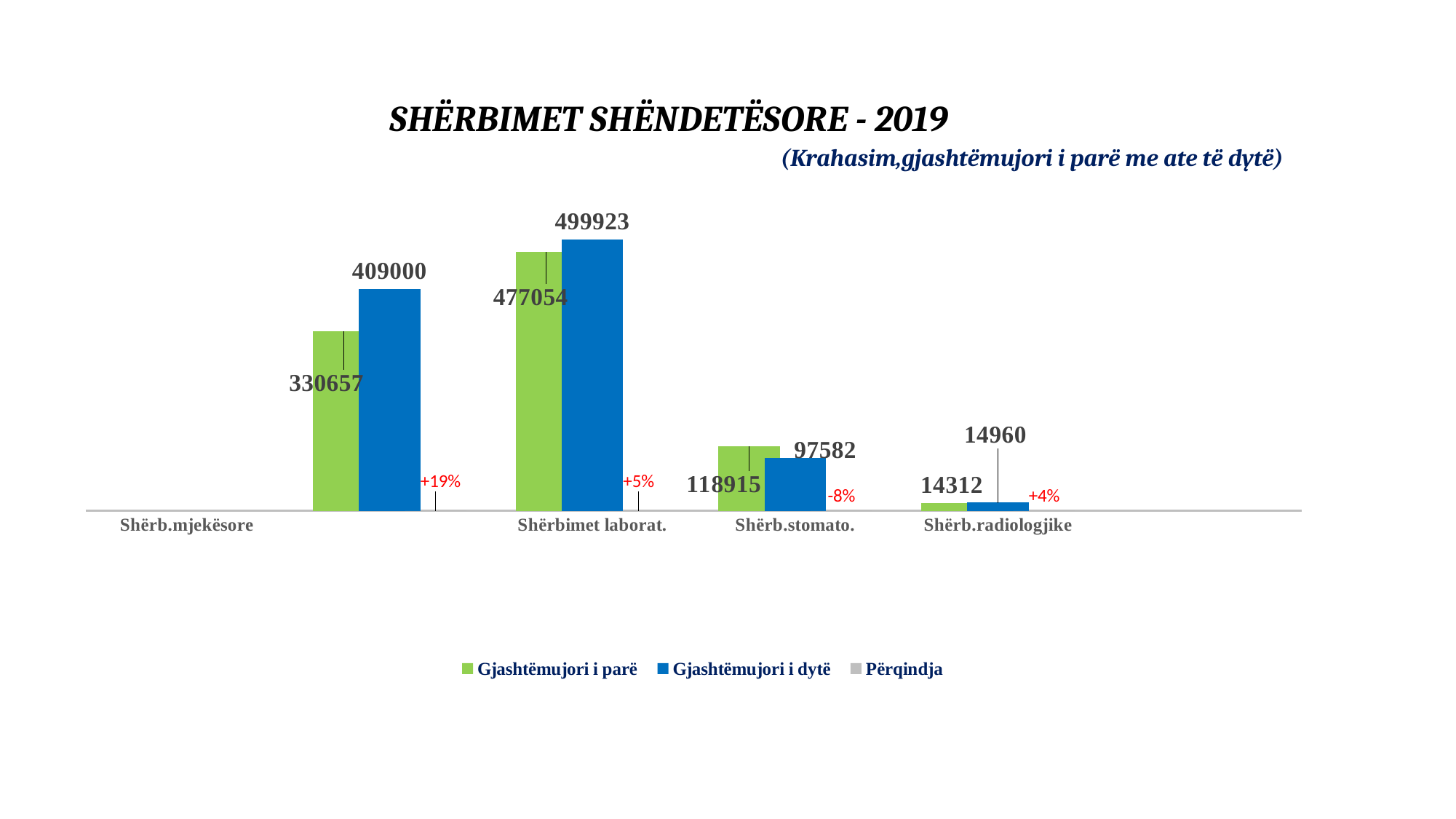
How many series does the legend list? 3 What percentage (Përqindja) is shown for Shërb.mjekësore? +19% What is the difference between Gjashtëmujori i dytë and Gjashtëmujori i parë for Shërb.mjekësore? 78343 For Shërb.stomato., which is larger: Gjashtëmujori i parë or Gjashtëmujori i dytë? Gjashtëmujori i parë Which category has the highest Gjashtëmujori i dytë value? Shërbimet laborat. What is the value of Gjashtëmujori i parë for Shërb.mjekësore? 330657 How many categories are shown on the x axis? 4 What percentage (Përqindja) is shown for Shërb.stomato.? -8% What is the value of Gjashtëmujori i dytë for Shërbimet laborat.? 499923 Which category has the lowest Gjashtëmujori i parë value? Shërb.radiologjike What is the value of Gjashtëmujori i dytë for Shërb.stomato.? 97582 What type of chart is shown on the slide? Bar chart